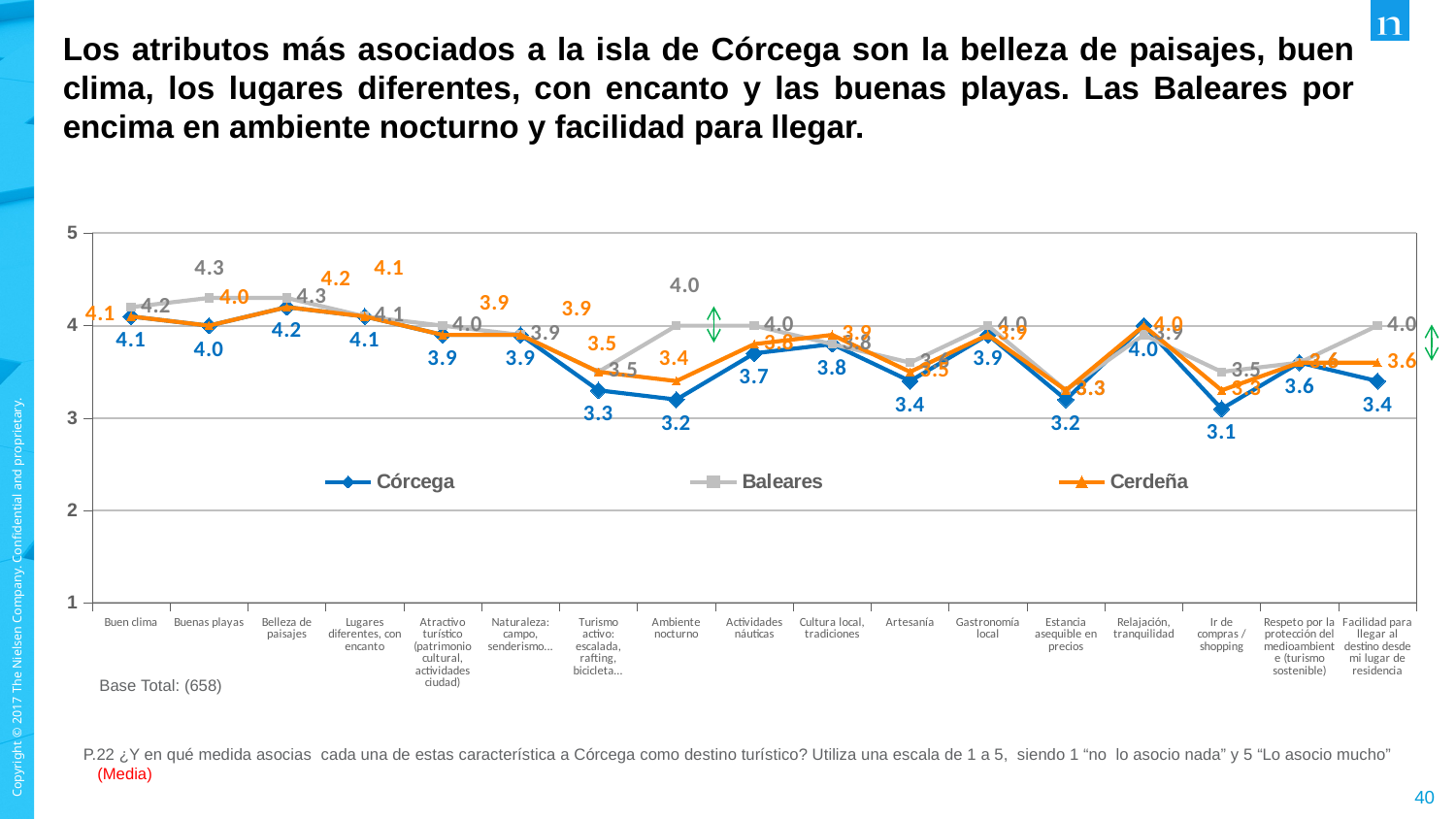
What is the value for Córcega for 'Buen clima'? 4.1 For which attribute does Córcega have its highest value? Belleza de paisajes What is the value for Córcega for 'Ambiente nocturno'? 3.2 How many series does the chart legend list? 3 What is the difference between Córcega's value for 'Belleza de paisajes' and its value for 'Ir de compras / shopping'? 1.1 What is the value for Baleares for 'Buenas playas'? 4.3 How many attribute categories are plotted along the x axis? 17 What is the value for Cerdeña for 'Facilidad para llegar al destino desde mi lugar de residencia'? 3.6 Which series is drawn in orange in the chart legend? Cerdeña For 'Ambiente nocturno', which series has the larger value, Córcega or Baleares? Baleares What type of chart is shown on the slide? Line chart For which attribute does Córcega have its lowest value? Ir de compras / shopping